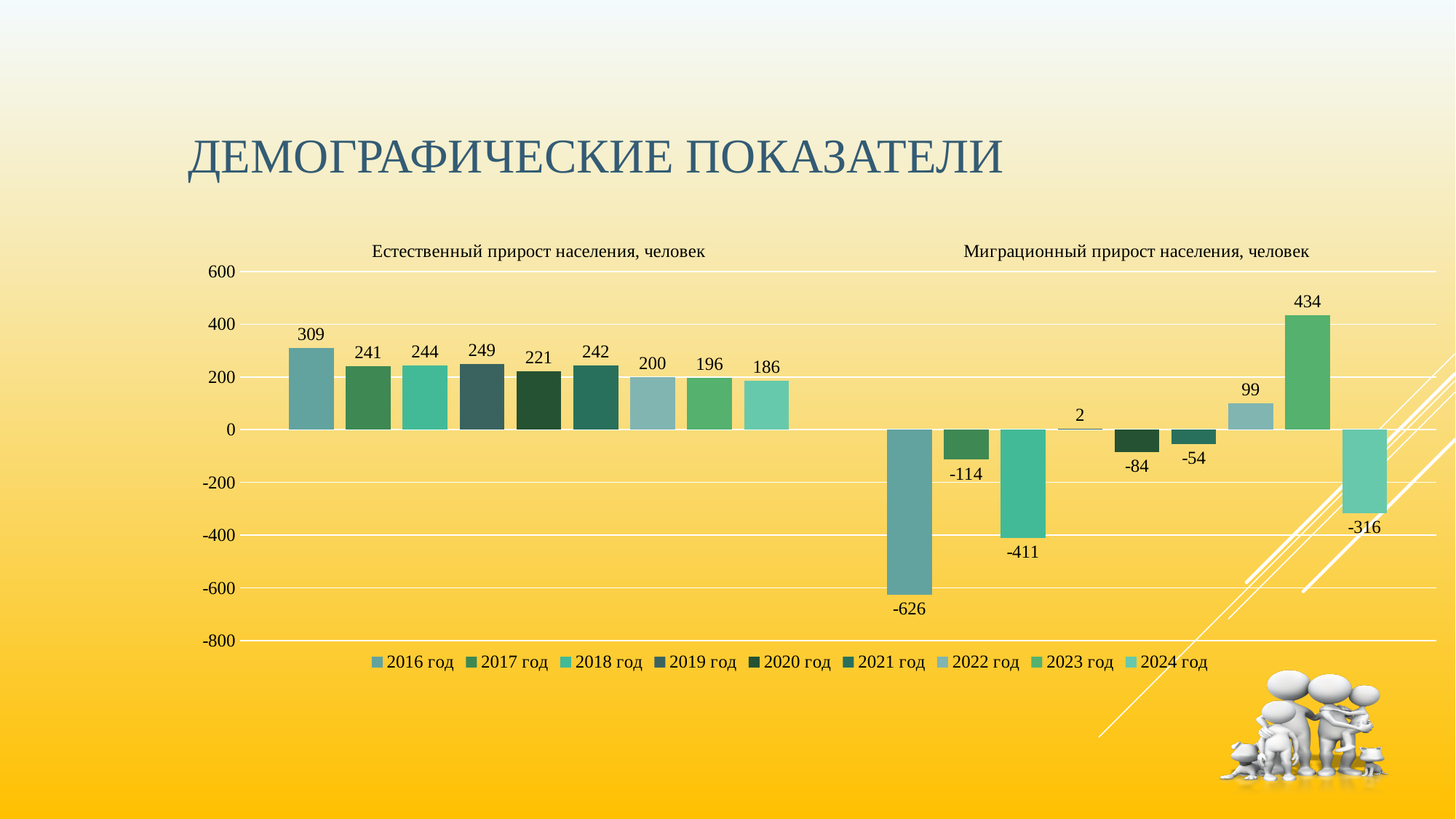
What is the difference between the natural population growth for 2016 год and 2024 год? 123 How many series does the legend list? 9 Which year has the highest natural population growth (Естественный прирост населения)? 2016 год What is the migration growth (Миграционный прирост населения) for 2023 год? 434 Which is larger: the migration growth for 2017 год or for 2020 год? 2020 год What is the natural population growth (Естественный прирост населения) for 2016 год? 309 What kind of chart is shown on the slide? Bar chart What is the natural population growth (Естественный прирост населения) for 2024 год? 186 Do the natural population growth values (Естественный прирост населения) generally rise or fall from 2016 год to 2024 год? Fall What is the title of the slide? ДЕМОГРАФИЧЕСКИЕ ПОКАЗАТЕЛИ What is the migration growth (Миграционный прирост населения) for 2016 год? -626 Which year has the lowest migration growth (Миграционный прирост населения)? 2016 год